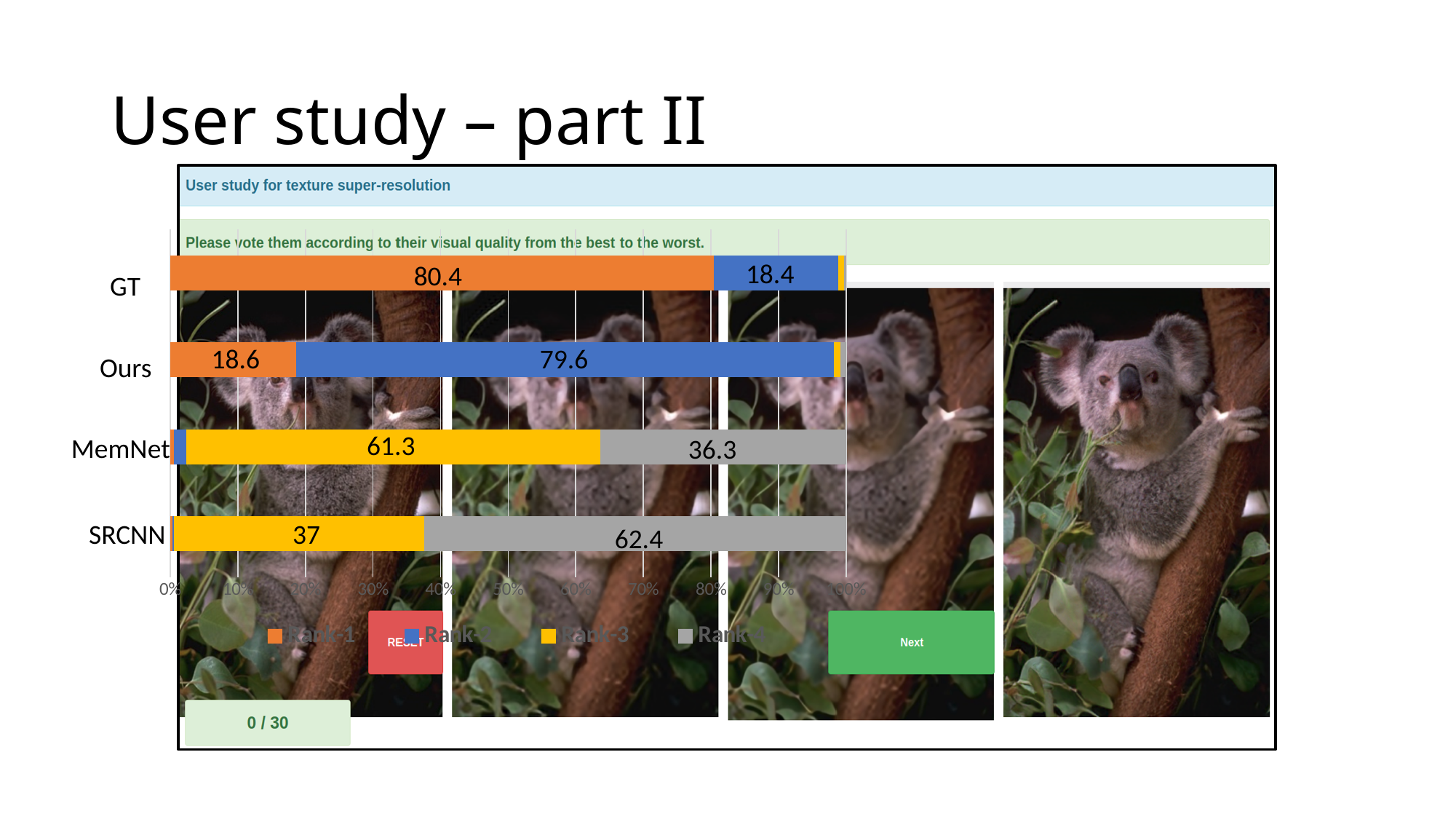
What is the Rank-1 value for GT? 80.4 How many series does the legend list? 4 How many categories are shown on the y axis of the chart? 4 Which category has the highest Rank-1 value? GT Which category has the largest Rank-4 value? SRCNN What is the difference between the Rank-3 values of MemNet and SRCNN? 24.3 Which is larger: the Rank-2 value for GT or the Rank-2 value for Ours? Ours What is the Rank-4 value for SRCNN? 62.4 What is the Rank-3 value for MemNet? 61.3 What is the Rank-2 value for Ours? 79.6 What kind of chart is shown on the slide? stacked bar chart What is the Rank-1 value for Ours? 18.6